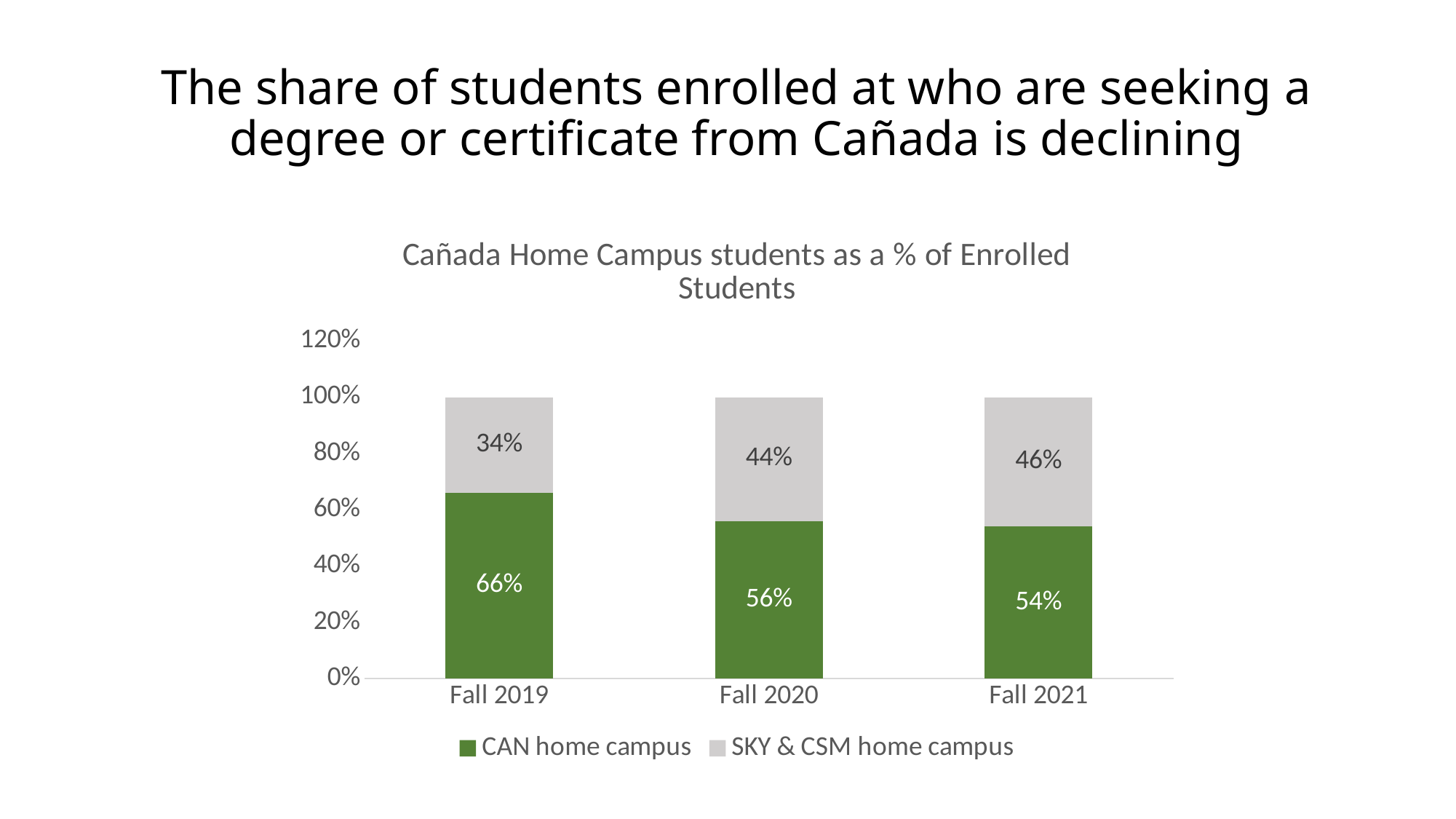
What is the difference between the CAN home campus share in Fall 2019 and Fall 2021? 12% What is the title of the chart? Cañada Home Campus students as a % of Enrolled Students What is the value for CAN home campus in Fall 2019? 66% Does the CAN home campus share rise or fall from Fall 2019 to Fall 2021? Fall How many series does the legend list? 2 What kind of chart is shown? Stacked bar chart What is the value for SKY & CSM home campus in Fall 2021? 46% What is the value for CAN home campus in Fall 2020? 56% How many years are shown on the x axis? 3 In which year is the SKY & CSM home campus share lowest? Fall 2019 Which is larger in Fall 2020: the CAN home campus share or the SKY & CSM home campus share? CAN home campus In which year is the CAN home campus share highest? Fall 2019